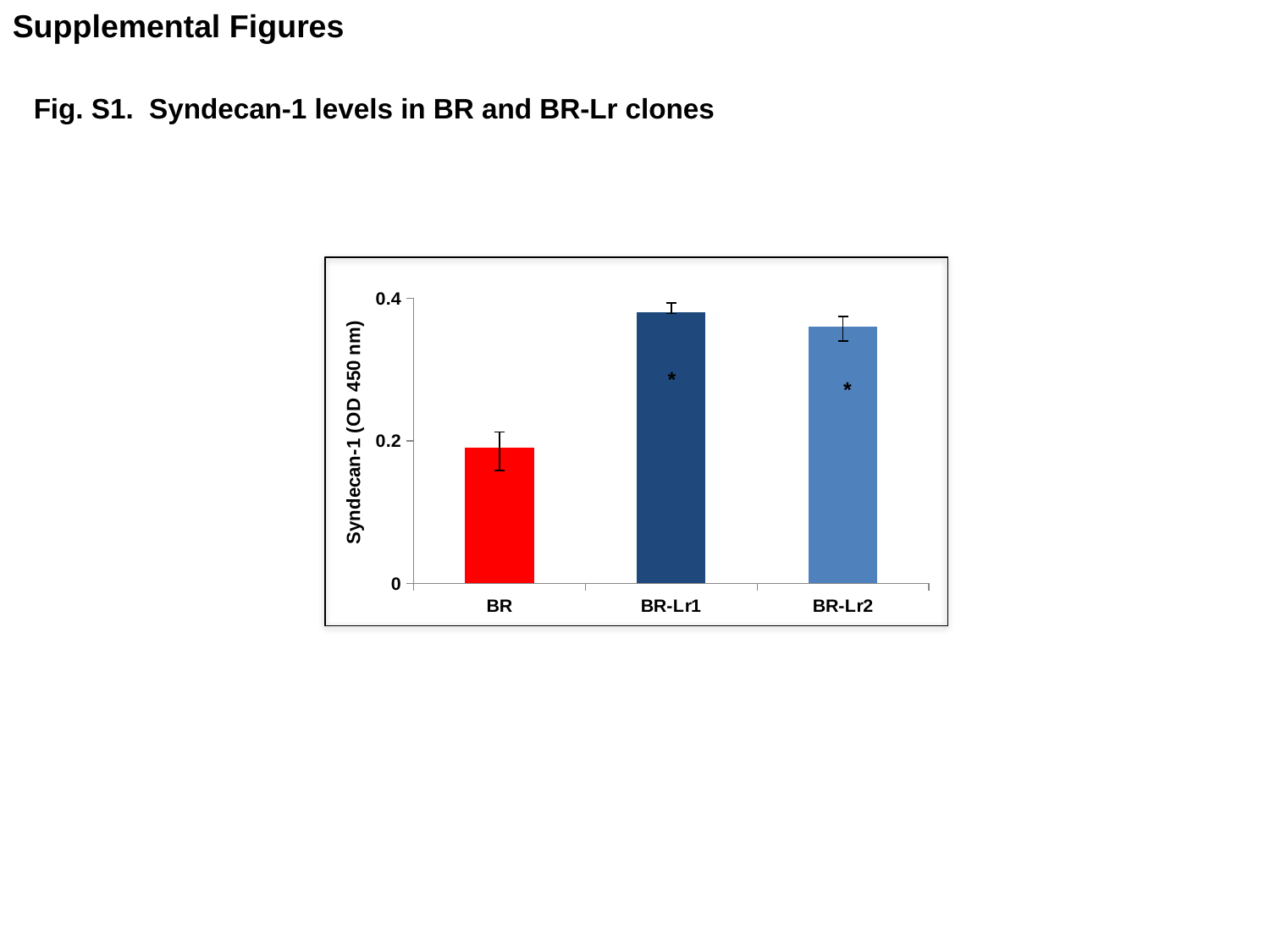
Is the value for BR-Lr1 greater or less than 0.4? less What colour is the bar for BR? red How many categories are plotted on the x axis? 3 Which category has the highest Syndecan-1 level? BR-Lr1 What kind of chart is shown on the slide? bar chart Which category has the lowest Syndecan-1 level? BR Which has a larger Syndecan-1 level, BR or BR-Lr1? BR-Lr1 Is the value for BR-Lr2 greater or less than 0.2? greater Which has a larger Syndecan-1 level, BR or BR-Lr2? BR-Lr2 What is the label of the y axis? Syndecan-1 (OD 450 nm)